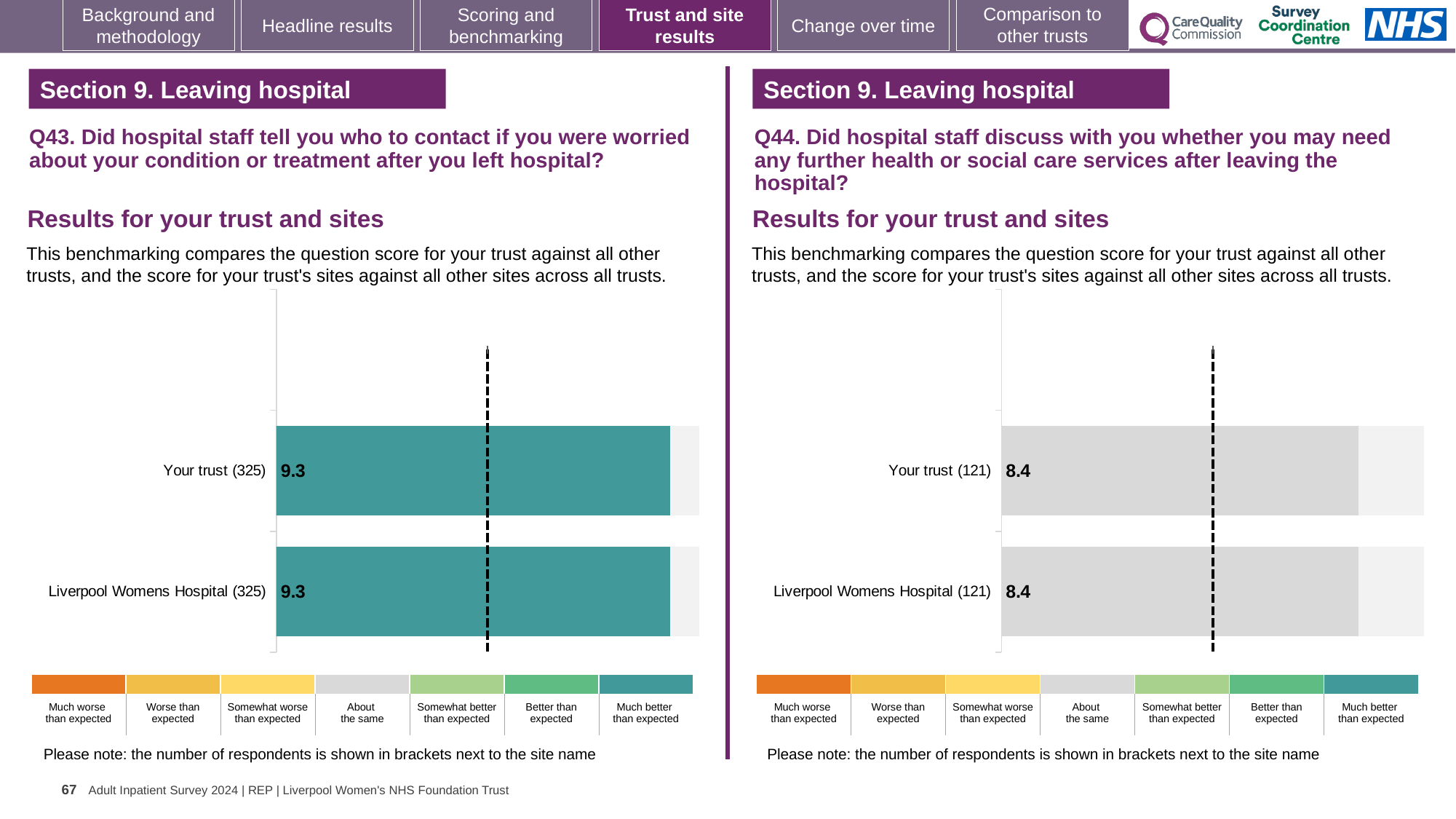
In the Q43 chart on the left, how many respondents are shown in brackets next to Your trust? 325 In the Q43 chart on the left, what is the score for Your trust? 9.3 In the Q43 chart on the left, what is the score for Liverpool Womens Hospital? 9.3 In the Q44 chart on the right, what is the score for Liverpool Womens Hospital? 8.4 In the Q44 chart on the right, what is the score for Your trust? 8.4 In the Q44 chart on the right, how many respondents are shown in brackets next to Liverpool Womens Hospital? 121 According to the colour key, which benchmark category do the bars in the Q43 chart on the left fall into? Much better than expected According to the colour key, which benchmark category do the bars in the Q44 chart on the right fall into? About the same Is the score for Your trust higher in the Q43 chart on the left or in the Q44 chart on the right? Q43 chart on the left What kind of chart is used in the Q43 chart on the left? Bar chart How many bars are plotted in the Q44 chart on the right? 2 In the Q43 chart on the left, what is the difference between the score for Your trust and the score for Liverpool Womens Hospital? 0